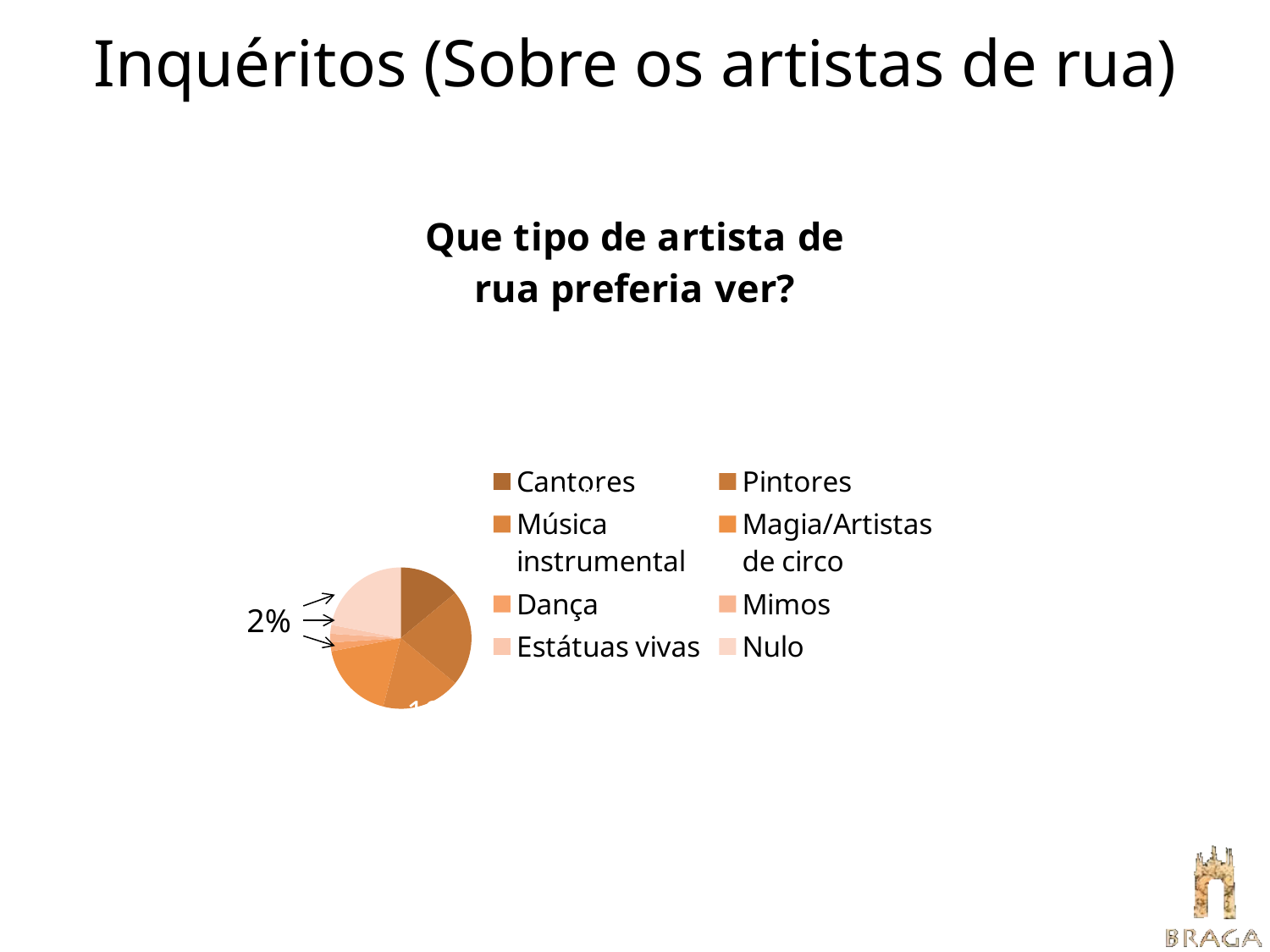
Which slice is larger in the pie chart, Cantores or Mimos? Cantores Which slice is larger in the pie chart, Nulo or Estátuas vivas? Nulo Which slice is larger in the pie chart, Pintores or Dança? Pintores Which category is listed first in the pie chart's legend? Cantores What kind of chart is shown on the slide? pie chart How many categories does the legend of the pie chart list? 8 What is the title of the pie chart? Que tipo de artista de rua preferia ver?